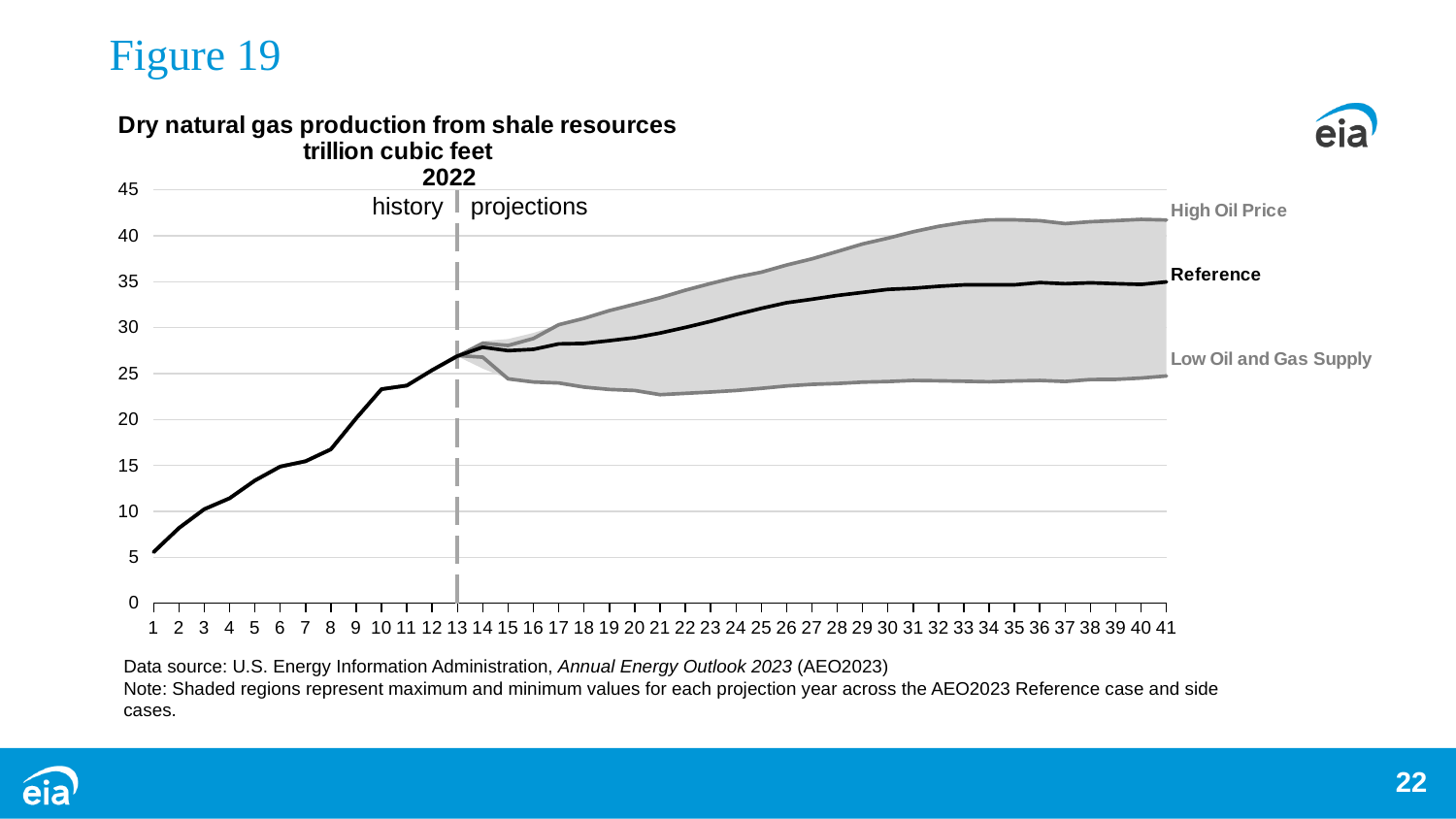
Which line is highest at point 41: High Oil Price, Reference, or Low Oil and Gas Supply? High Oil Price Is the value of the Low Oil and Gas Supply line at point 21 greater or less than 25? less What kind of chart is shown on the slide? line chart Is the value of the High Oil Price line at point 41 greater or less than 40? greater At point 41, which is larger: the High Oil Price value or the Low Oil and Gas Supply value? High Oil Price Is the value of the Reference line at point 13 greater or less than 25? greater What is the title of the chart? Dry natural gas production from shale resources What unit is the chart's y axis measured in? trillion cubic feet How many points are labelled along the x axis? 41 Does the line rise or fall from point 1 to point 13 in the history period? rise